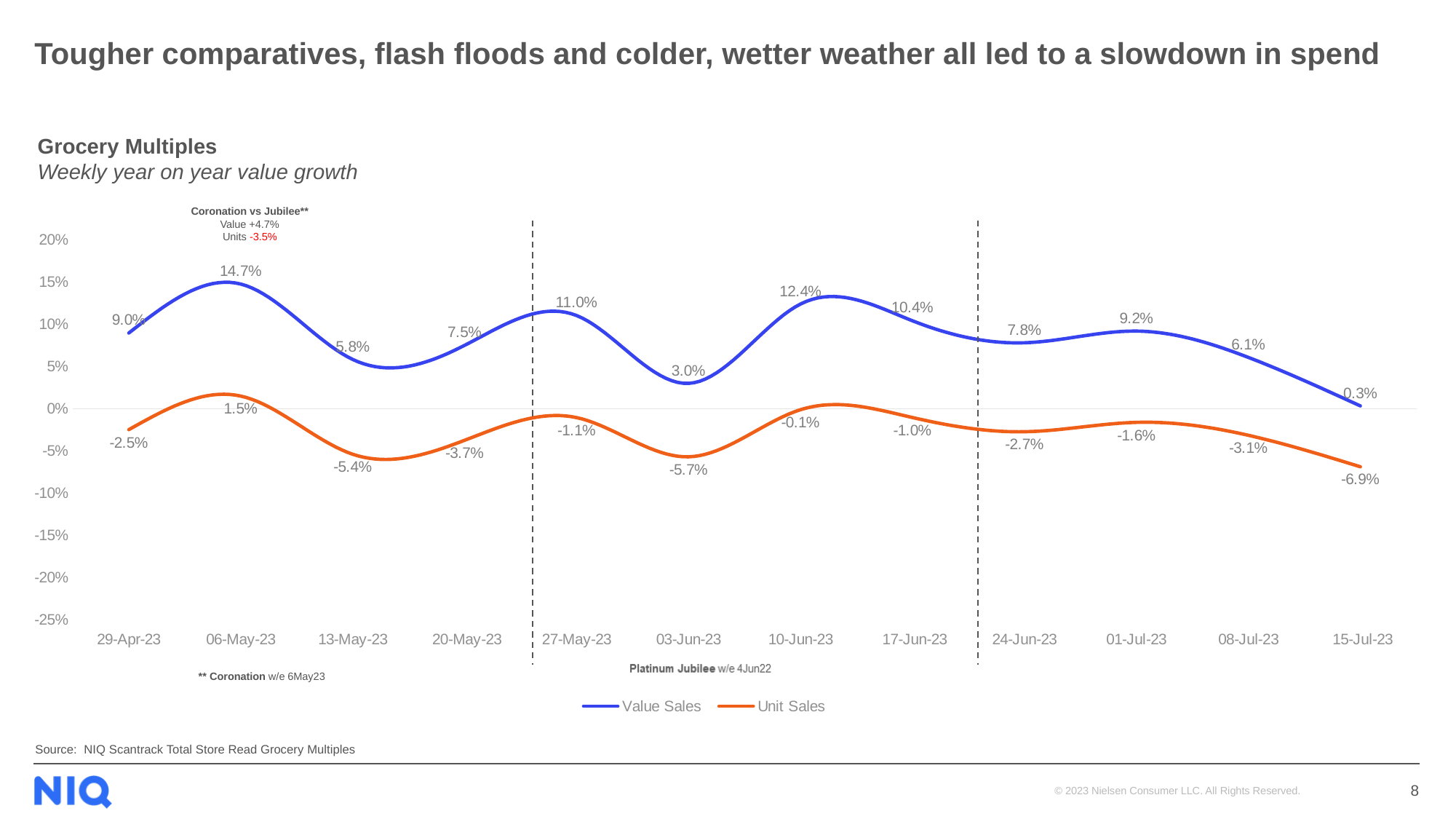
How many series does the legend list? 2 Do Value Sales growth values rise or fall from 24-Jun-23 to 15-Jul-23? Fall Which week has the lowest Unit Sales growth? 15-Jul-23 Is the Value Sales growth for 27-May-23 greater or less than 10%? greater What is the Unit Sales growth for the week of 15-Jul-23? -6.9% What is the difference between Value Sales and Unit Sales growth for the week of 03-Jun-23? 8.7 percentage points What type of chart is shown on the slide? Line chart What is the subtitle of the chart below 'Grocery Multiples'? Weekly year on year value growth How many weekly data points are plotted along the x axis? 12 Which is larger, the Value Sales growth for 10-Jun-23 or for 17-Jun-23? 10-Jun-23 What is the Value Sales growth for the week of 06-May-23? 14.7% Which week has the highest Value Sales growth? 06-May-23